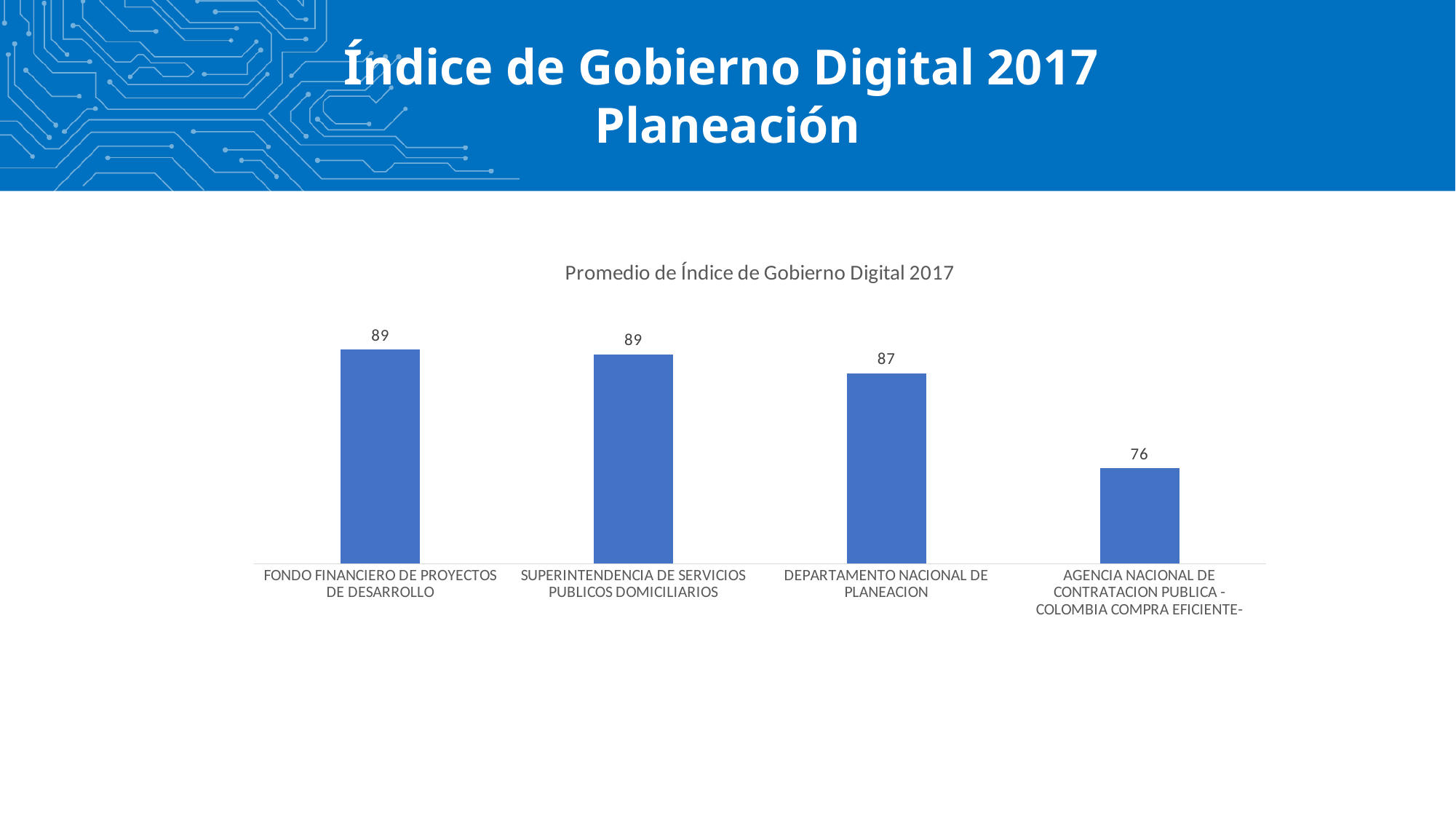
What is the value for SUPERINTENDENCIA DE SERVICIOS PUBLICOS DOMICILIARIOS? 89 What kind of chart is shown on the slide? Bar chart What is the difference between the values for FONDO FINANCIERO DE PROYECTOS DE DESARROLLO and DEPARTAMENTO NACIONAL DE PLANEACION? 2 What is the value for DEPARTAMENTO NACIONAL DE PLANEACION? 87 How many categories are shown in the chart? 4 Do the values rise or fall from left to right across the categories? Fall What is the value for AGENCIA NACIONAL DE CONTRATACION PUBLICA - COLOMBIA COMPRA EFICIENTE-? 76 Which category has the lowest value? AGENCIA NACIONAL DE CONTRATACION PUBLICA - COLOMBIA COMPRA EFICIENTE- What is the title of the chart? Promedio de Índice de Gobierno Digital 2017 Which is larger, the value for SUPERINTENDENCIA DE SERVICIOS PUBLICOS DOMICILIARIOS or the value for AGENCIA NACIONAL DE CONTRATACION PUBLICA - COLOMBIA COMPRA EFICIENTE-? SUPERINTENDENCIA DE SERVICIOS PUBLICOS DOMICILIARIOS What is the difference between the values for DEPARTAMENTO NACIONAL DE PLANEACION and AGENCIA NACIONAL DE CONTRATACION PUBLICA - COLOMBIA COMPRA EFICIENTE-? 11 What is the value for FONDO FINANCIERO DE PROYECTOS DE DESARROLLO? 89